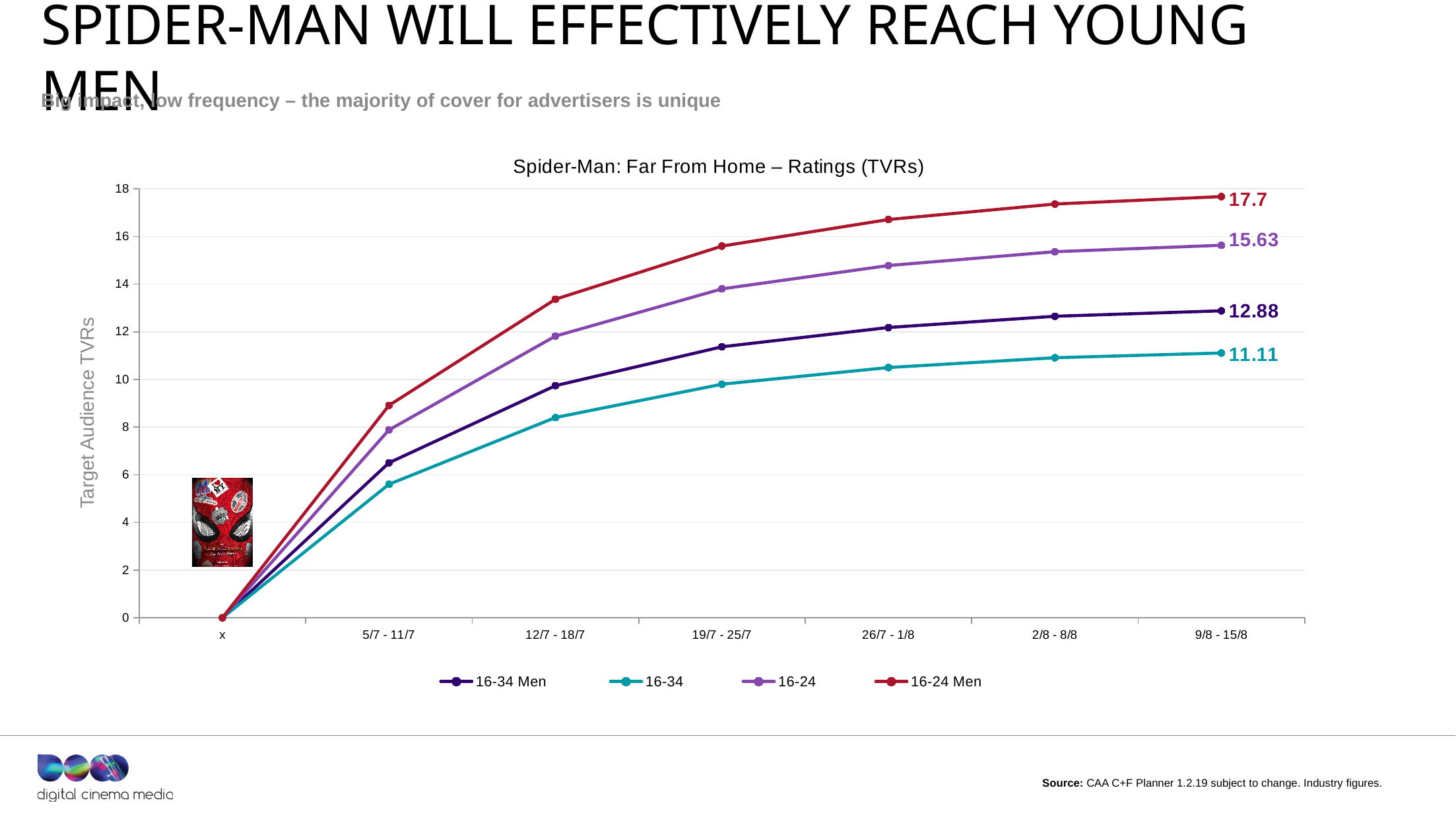
What is the final value for the 16-24 series at 9/8 - 15/8? 15.63 What is the final value for the 16-34 series at 9/8 - 15/8? 11.11 Do the values for the 16-24 Men series rise or fall along the x axis? rise What is the final value for the 16-34 Men series at 9/8 - 15/8? 12.88 What is the title of the chart? Spider-Man: Far From Home – Ratings (TVRs) What is the difference between the final values of 16-24 Men and 16-34 at 9/8 - 15/8? 6.59 What type of chart is shown on the slide? line chart How many points are plotted along the x axis for each series? 7 How many series does the legend list? 4 What is the final value for the 16-24 Men series at 9/8 - 15/8? 17.7 Which series has the lowest value at 9/8 - 15/8? 16-34 Which series has the highest value at 9/8 - 15/8? 16-24 Men